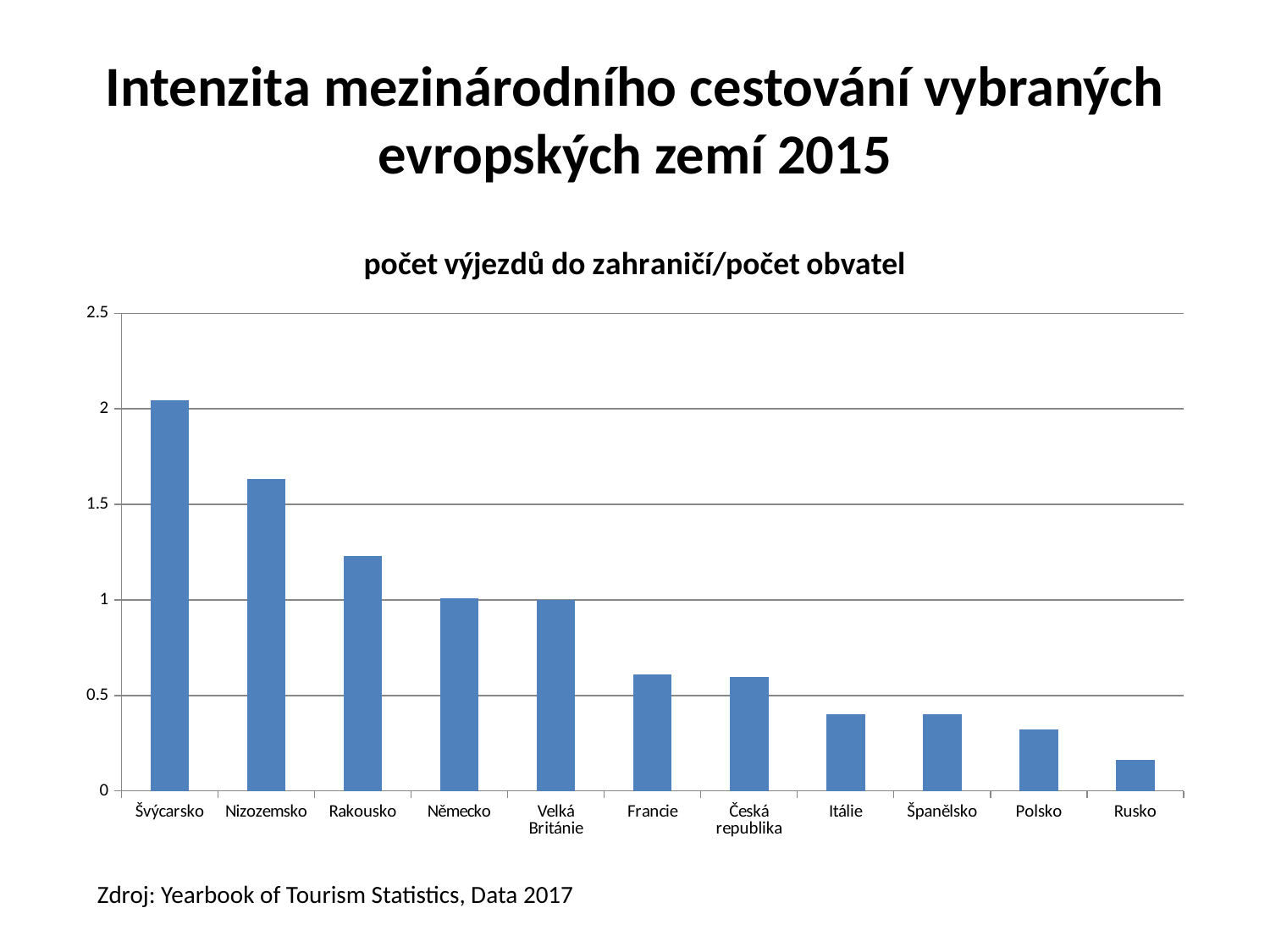
Which has the larger value, Švýcarsko or Nizozemsko? Švýcarsko Which country has the lowest value in the chart? Rusko Is the value for Rakousko greater or less than 1? greater Which country has the highest value in the chart? Švýcarsko Do the values rise or fall from left to right along the x axis? fall What kind of chart is shown on the slide? bar chart Is the value for Francie greater or less than 0.5? greater Is the value for Rusko greater or less than 0.5? less What is the title printed above the chart? počet výjezdů do zahraničí/počet obvatel How many countries are shown on the x axis of the chart? 11 Which has the larger value, Polsko or Rusko? Polsko